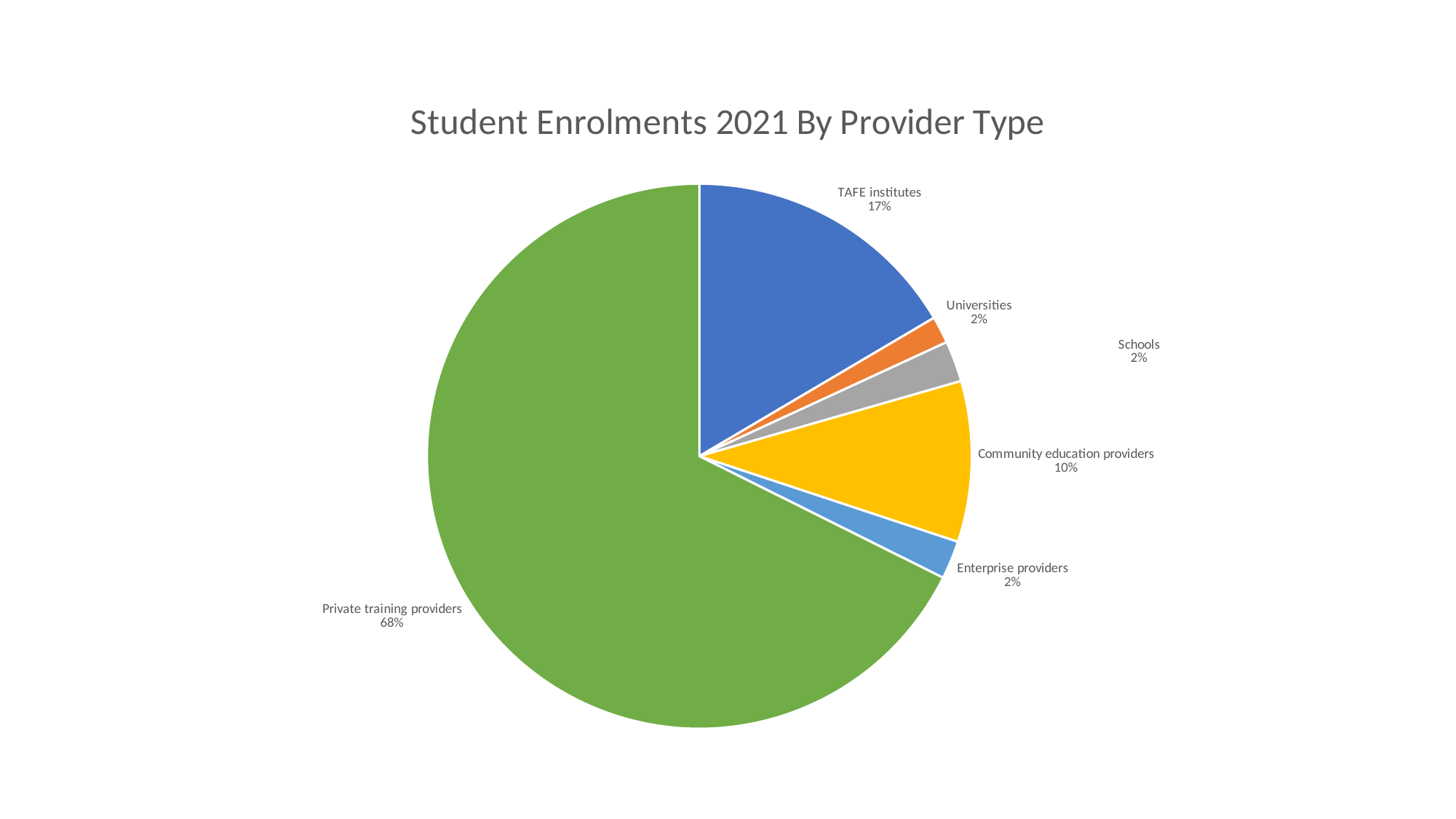
Which provider type has the largest share of student enrolments? Private training providers What kind of chart is shown on the slide? pie chart What is the title of the chart? Student Enrolments 2021 By Provider Type Which has a larger share, TAFE institutes or Community education providers? TAFE institutes What share of student enrolments is attributed to Private training providers? 68% What share of student enrolments is attributed to Community education providers? 10% What is the difference in share between TAFE institutes and Community education providers? 7% What is the difference in share between Private training providers and TAFE institutes? 51% How many provider types are shown in the pie chart? 6 What share of student enrolments is attributed to Universities? 2% What colour is the slice for Private training providers? green